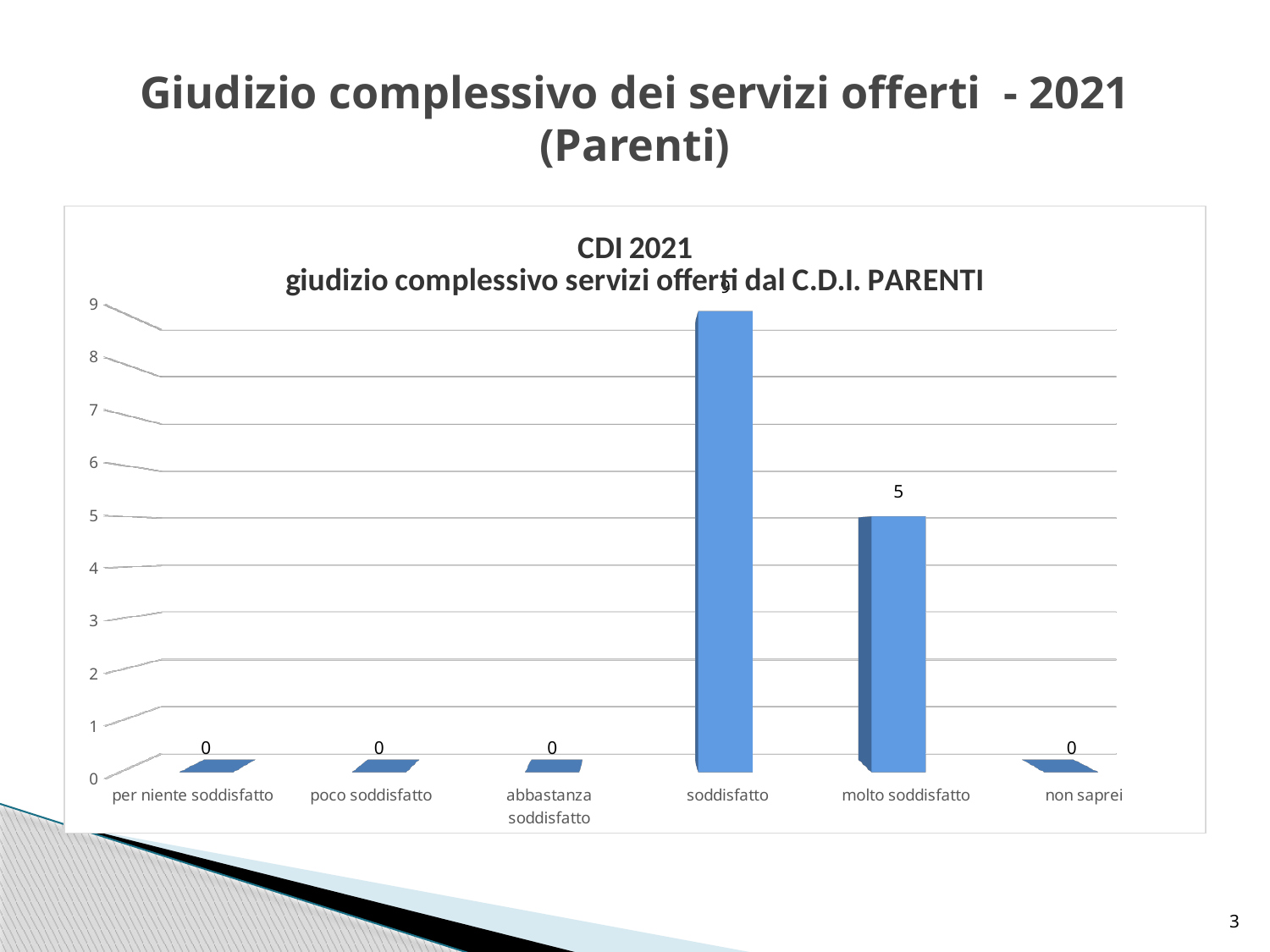
Which is larger, the value for "soddisfatto" or the value for "molto soddisfatto"? soddisfatto How many categories are shown on the x axis? 6 What is the value for "soddisfatto"? 9 What is the value for "abbastanza soddisfatto"? 0 What kind of chart is shown on the slide? bar chart What is the value for "molto soddisfatto"? 5 Which category has the highest value? soddisfatto What is the value for "non saprei"? 0 What is the first line of the chart title? CDI 2021 What is the value for "per niente soddisfatto"? 0 What is the difference between the values for "soddisfatto" and "molto soddisfatto"? 4 Is the value for "soddisfatto" greater or less than 8? greater